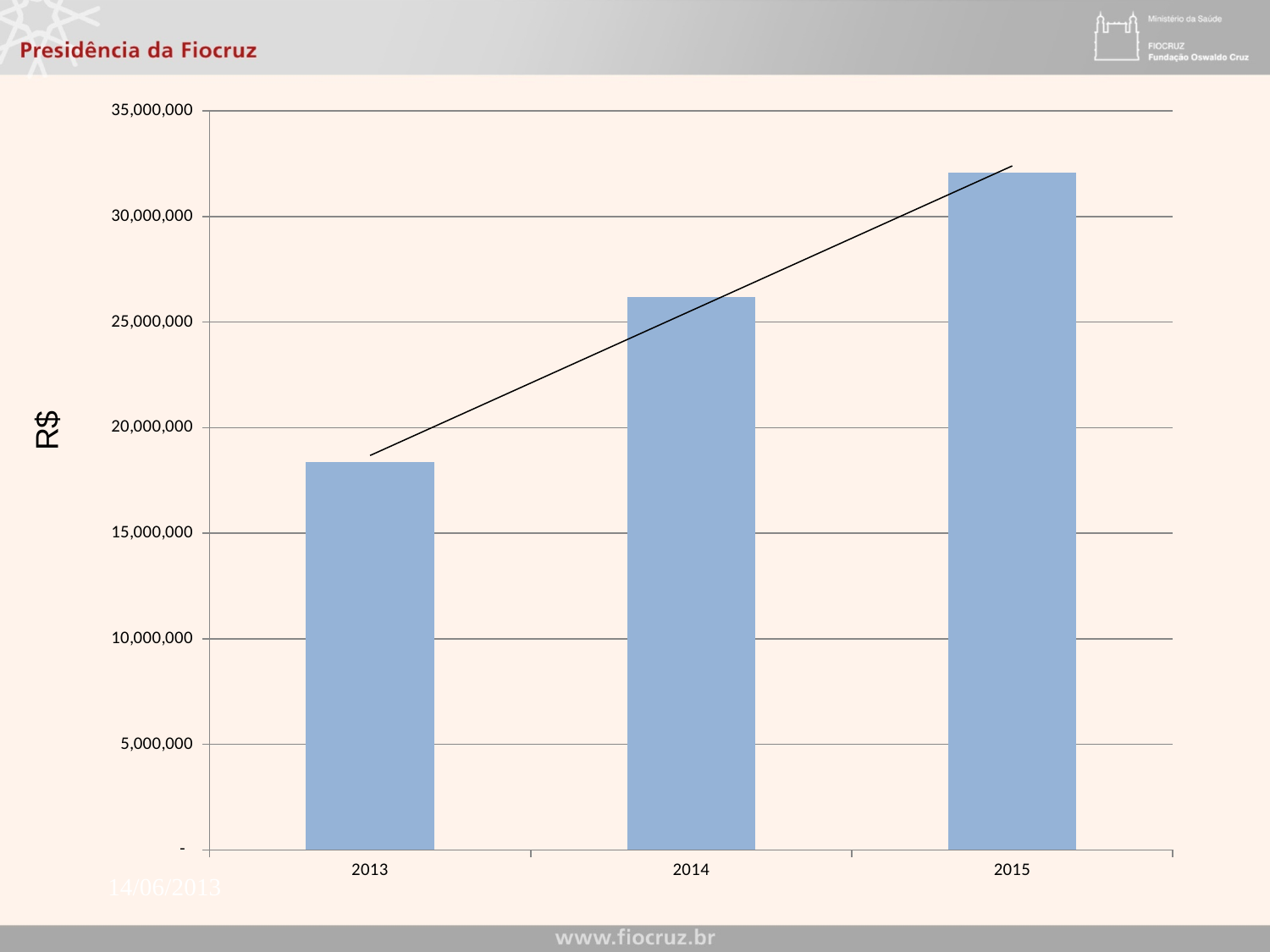
Is the value for 2014 greater or less than 25,000,000? greater Do the values rise or fall from 2013 to 2015? rise How many bars (years) are plotted in the chart? 3 Which year has the highest value in the chart? 2015 Which year has the lowest value in the chart? 2013 Is the value for 2015 greater or less than 35,000,000? less What kind of chart is shown on the slide? bar chart Which is larger, the value for 2014 or the value for 2013? 2014 Is the value for 2013 greater or less than 20,000,000? less What is the label on the vertical axis of the chart? R$ What is the highest value shown on the vertical axis of the chart? 35,000,000